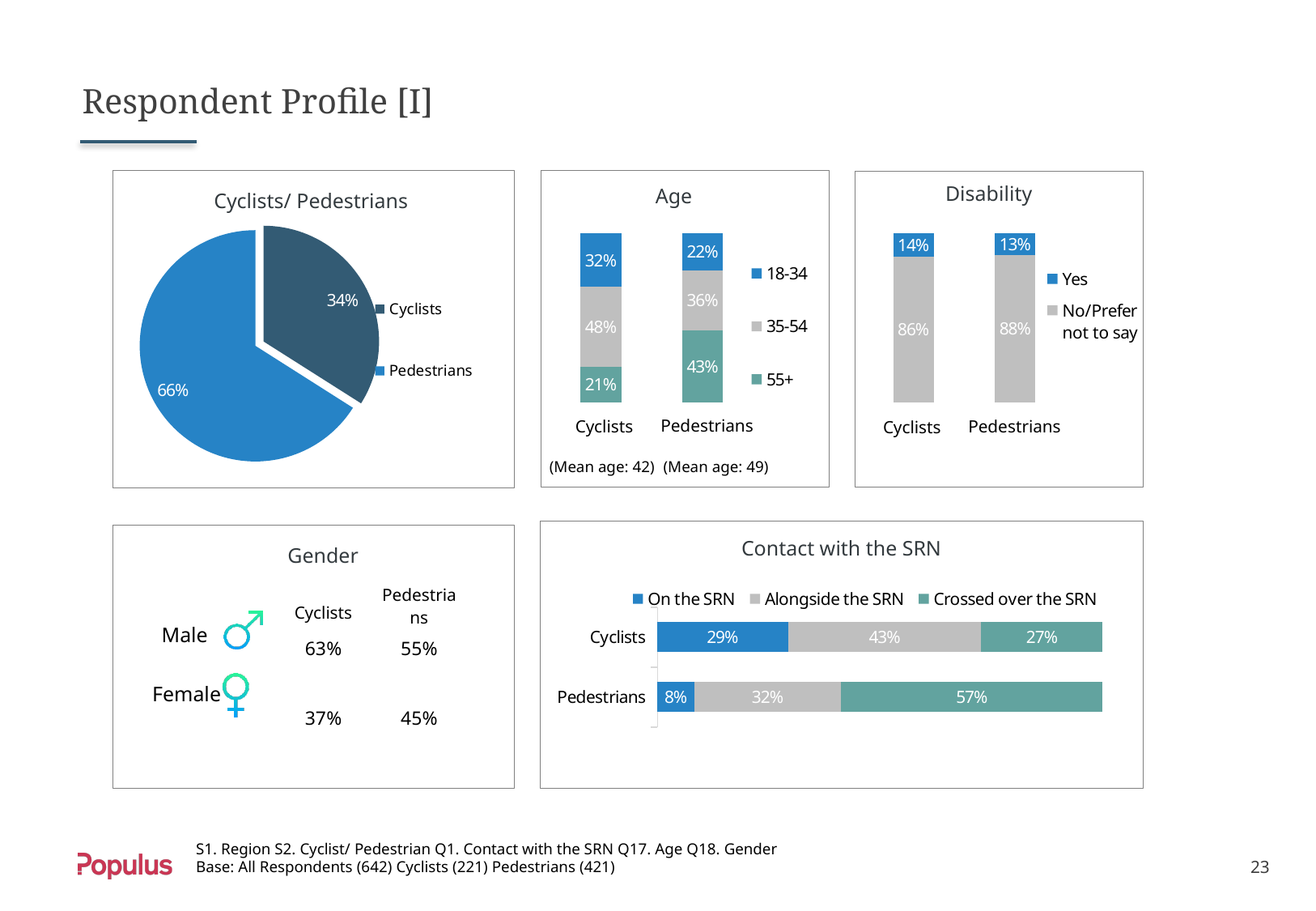
In the 'Cyclists/ Pedestrians' pie chart, what share of respondents are Pedestrians? 66% In the 'Age' chart, what percentage of Cyclists are aged 18-34? 32% In the 'Age' chart, what is the difference between the 35-54 share for Cyclists and for Pedestrians? 12 percentage points In the 'Age' chart, how many series does the legend list? 3 In the 'Disability' chart, what percentage of Pedestrians answered Yes? 13% In the 'Contact with the SRN' chart, what percentage of Pedestrians crossed over the SRN? 57% What kind of chart is the 'Cyclists/ Pedestrians' chart? Pie chart What kind of chart is the 'Contact with the SRN' chart? Stacked bar chart In the 'Disability' chart, which group has the higher 'No/Prefer not to say' share, Cyclists or Pedestrians? Pedestrians In the 'Age' chart, what percentage of Pedestrians are aged 55+? 43% In the 'Contact with the SRN' chart, which category has the largest share for Cyclists? Alongside the SRN In the 'Cyclists/ Pedestrians' pie chart, what share of respondents are Cyclists? 34%